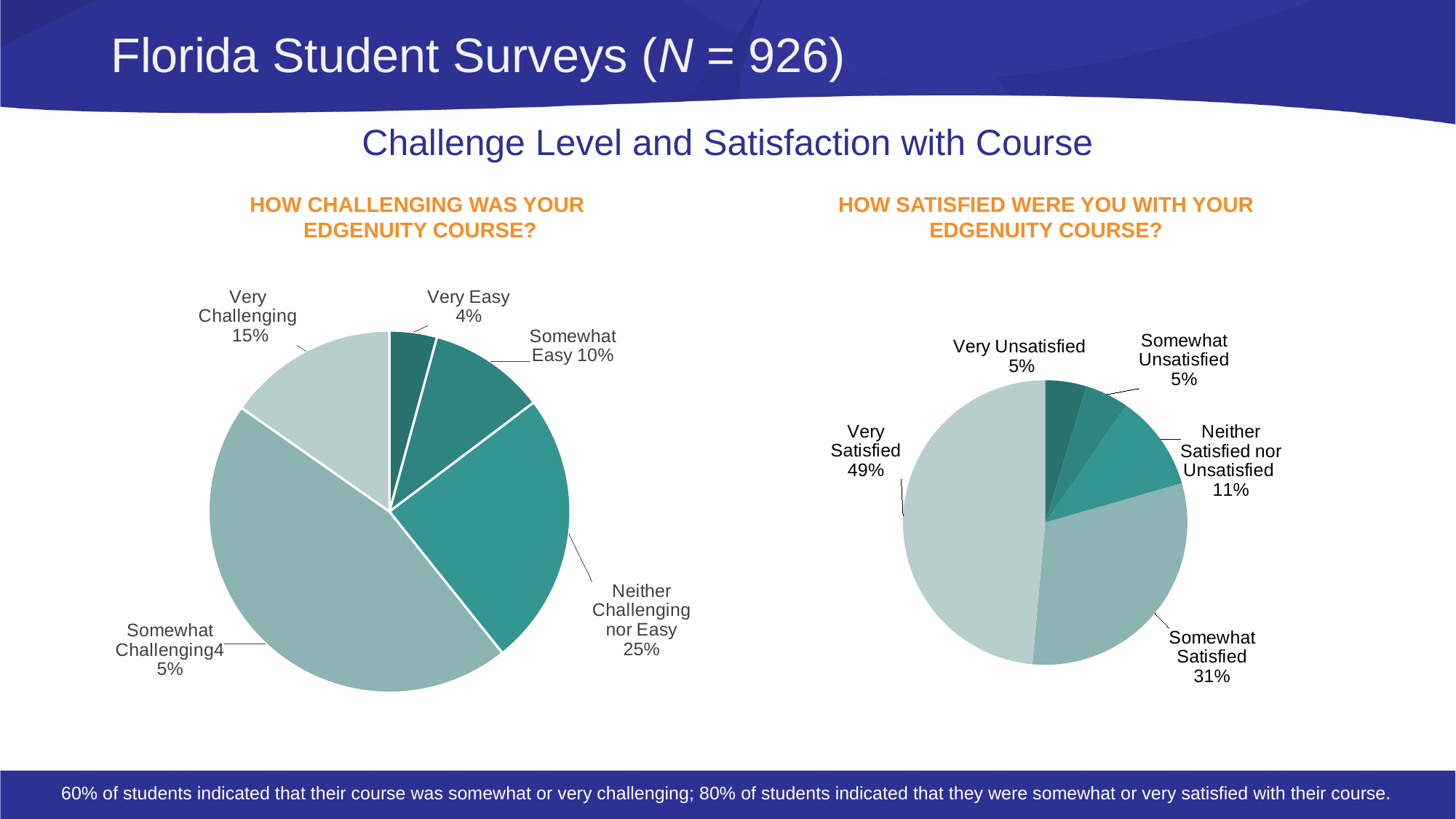
In the 'How satisfied were you with your Edgenuity course?' chart, what percentage of students were Neither Satisfied nor Unsatisfied? 11% How many slices does the 'How satisfied were you with your Edgenuity course?' chart have? 5 What type of chart is used for 'How challenging was your Edgenuity course?'? Pie chart In the 'How satisfied were you with your Edgenuity course?' chart, which is larger, Somewhat Satisfied or Neither Satisfied nor Unsatisfied? Somewhat Satisfied In the 'How challenging was your Edgenuity course?' chart, which response has the smallest slice? Very Easy In the 'How challenging was your Edgenuity course?' chart, what percentage of students said the course was Very Easy? 4% In the 'How challenging was your Edgenuity course?' chart, what is the difference between the Very Challenging and Somewhat Easy percentages? 5% In the 'How satisfied were you with your Edgenuity course?' chart, what is the difference between the Very Satisfied and Somewhat Satisfied percentages? 18% In the 'How satisfied were you with your Edgenuity course?' chart, what percentage of students were Very Satisfied? 49% In the 'How challenging was your Edgenuity course?' chart, what percentage of students said the course was Neither Challenging nor Easy? 25% In the 'How challenging was your Edgenuity course?' chart, what percentage of students said the course was Very Challenging? 15% In the 'How challenging was your Edgenuity course?' chart, which response has the largest slice? Somewhat Challenging